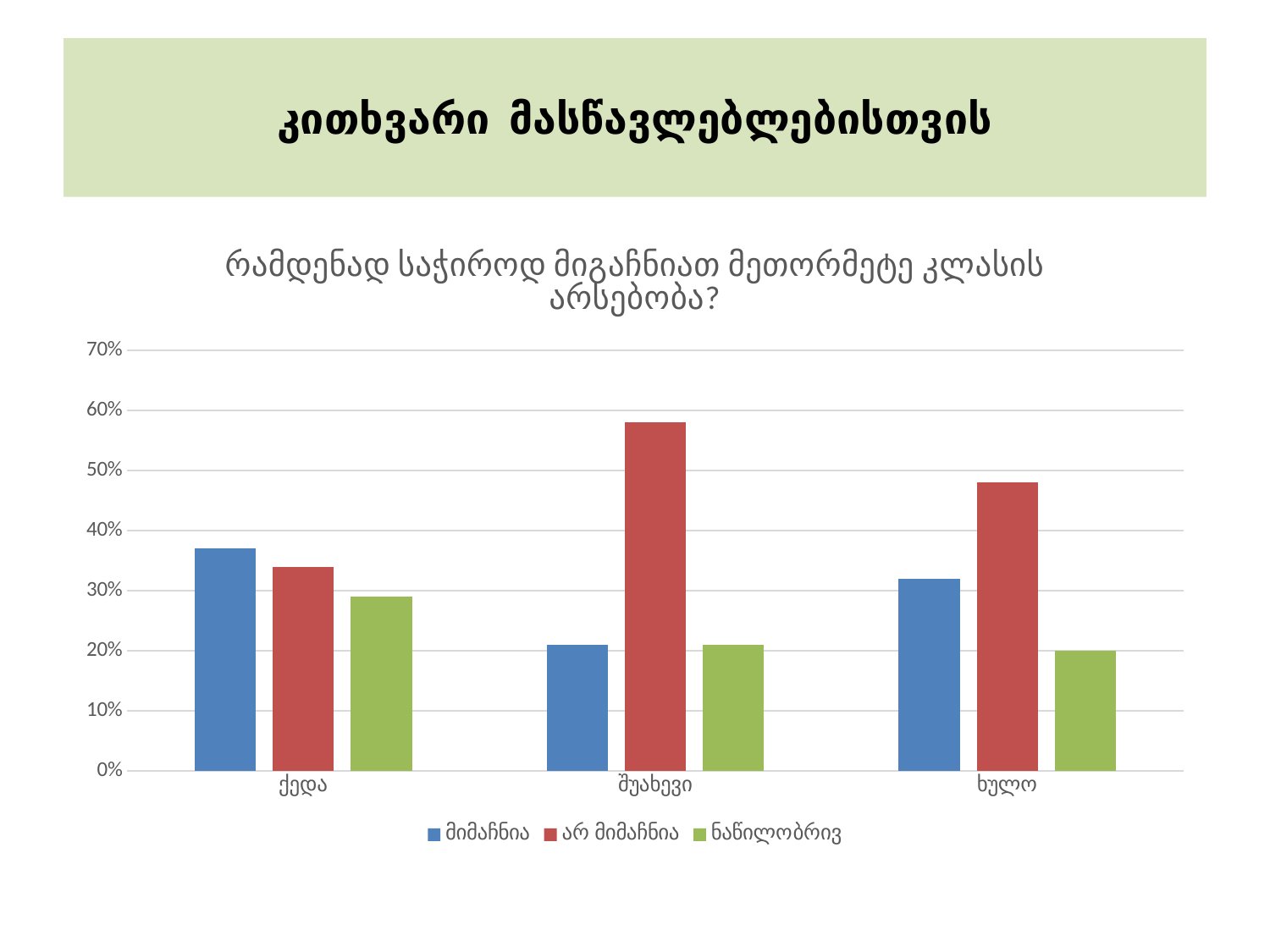
What kind of chart is shown on the slide? bar chart Is the value for ნაწილობრივ in ხულო greater or less than 30%? less Which category has the highest value for არ მიმაჩნია? შუახევი How many series does the chart's legend list? 3 Is the value for მიმაჩნია in ქედა greater or less than 30%? greater Is the value for არ მიმაჩნია in შუახევი greater or less than 50%? greater In ხულო, which is larger: მიმაჩნია or არ მიმაჩნია? არ მიმაჩნია How many categories are shown on the x axis of the chart? 3 Which category has the lowest value for მიმაჩნია? შუახევი What colour represents the არ მიმაჩნია series in the chart? red Which category has the highest value for მიმაჩნია? ქედა